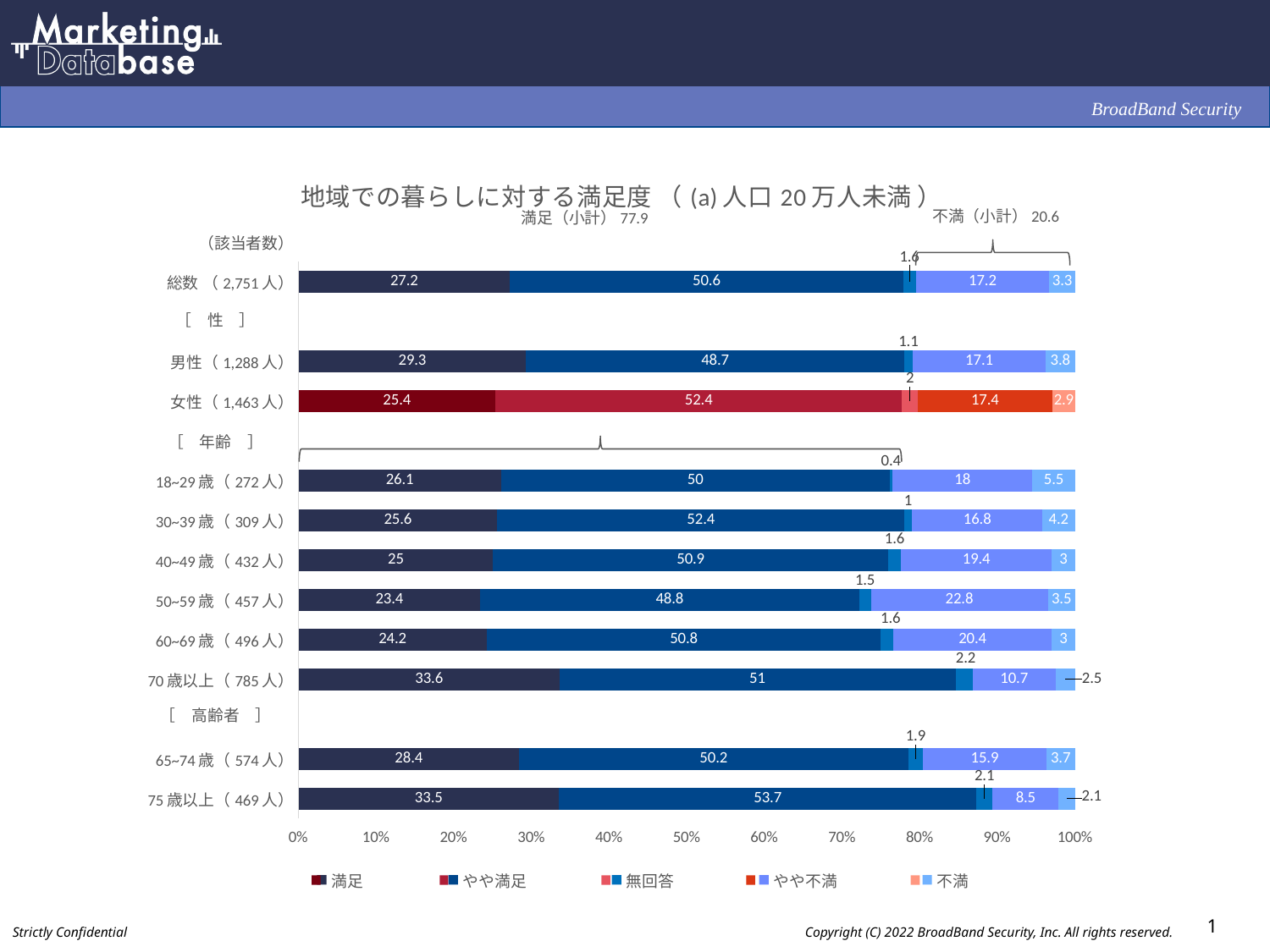
What is the difference between the 満足 values for 男性 (1,288人) and 女性 (1,463人)? 3.9 Which category has the highest value for やや不満? 50~59歳 (457人) How many series does the legend list? 5 What is the value of やや満足 for 総数 (2,751人)? 50.6 What kind of chart is shown on the slide? Stacked bar chart How many categories (respondent groups) are plotted in the chart? 11 Which category has the highest value for 不満? 18~29歳 (272人) What is the value of 無回答 for 18~29歳 (272人)? 0.4 Which category has the lowest value for やや不満? 75歳以上 (469人) What is the value of やや不満 for 50~59歳 (457人)? 22.8 What is the value of 満足 for 70歳以上 (785人)? 33.6 Which is larger, the やや満足 value for 75歳以上 (469人) or for 65~74歳 (574人)? 75歳以上 (469人)